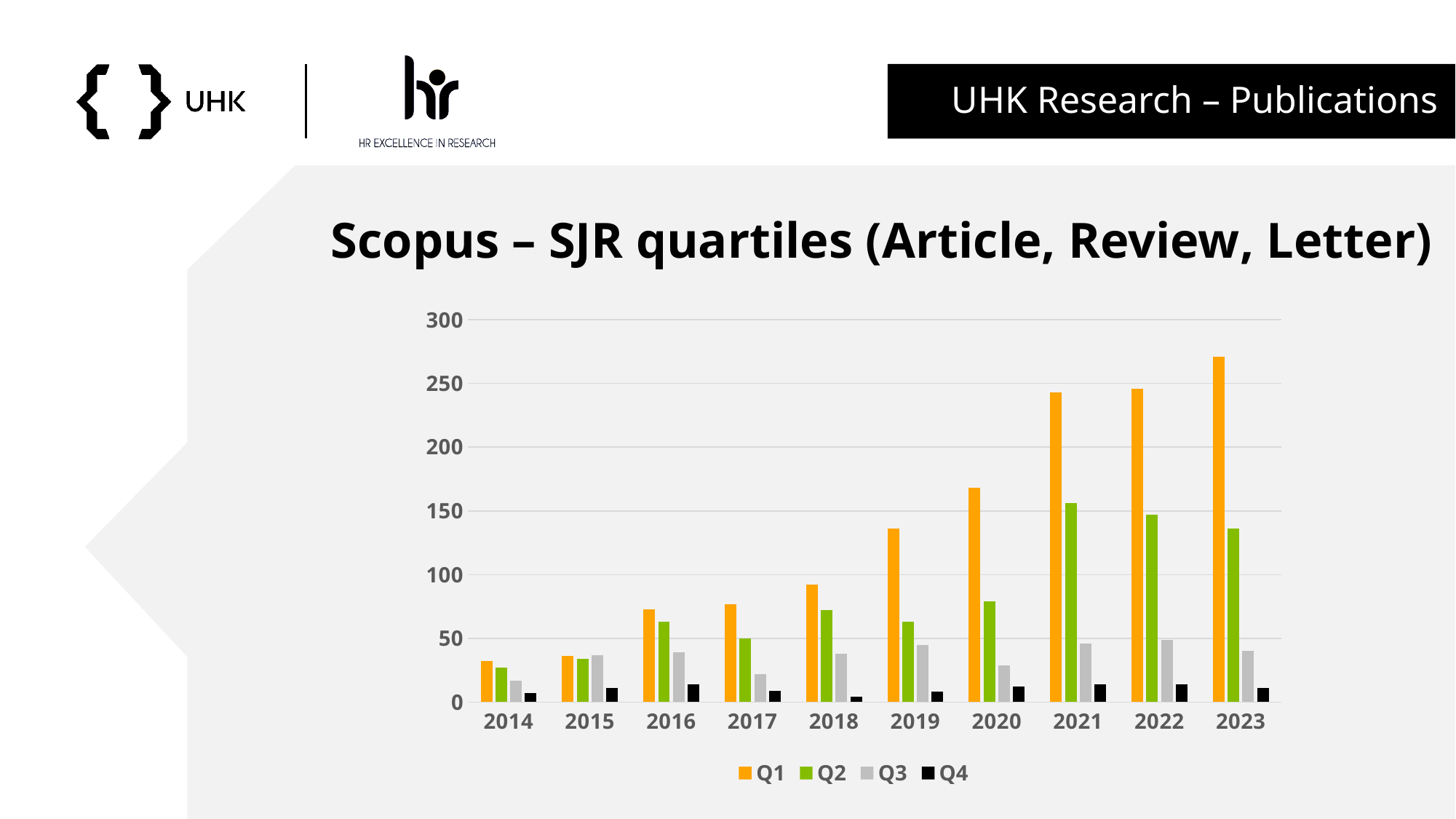
Is the Q2 value for 2021 greater or less than 100? greater Which is larger, the Q2 value for 2021 or the Q2 value for 2023? 2021 Do the Q1 values generally rise or fall from 2014 to 2023? rise Is the Q1 value for 2023 greater or less than 250? greater Is the Q1 value for 2020 greater or less than 150? greater In 2023, which is larger, the Q1 value or the Q2 value? Q1 What colour represents the Q1 series in the legend? Orange What kind of chart is shown on the slide? Bar chart How many years are shown on the x axis? 10 In which year is the Q1 value highest? 2023 How many series does the legend list? 4